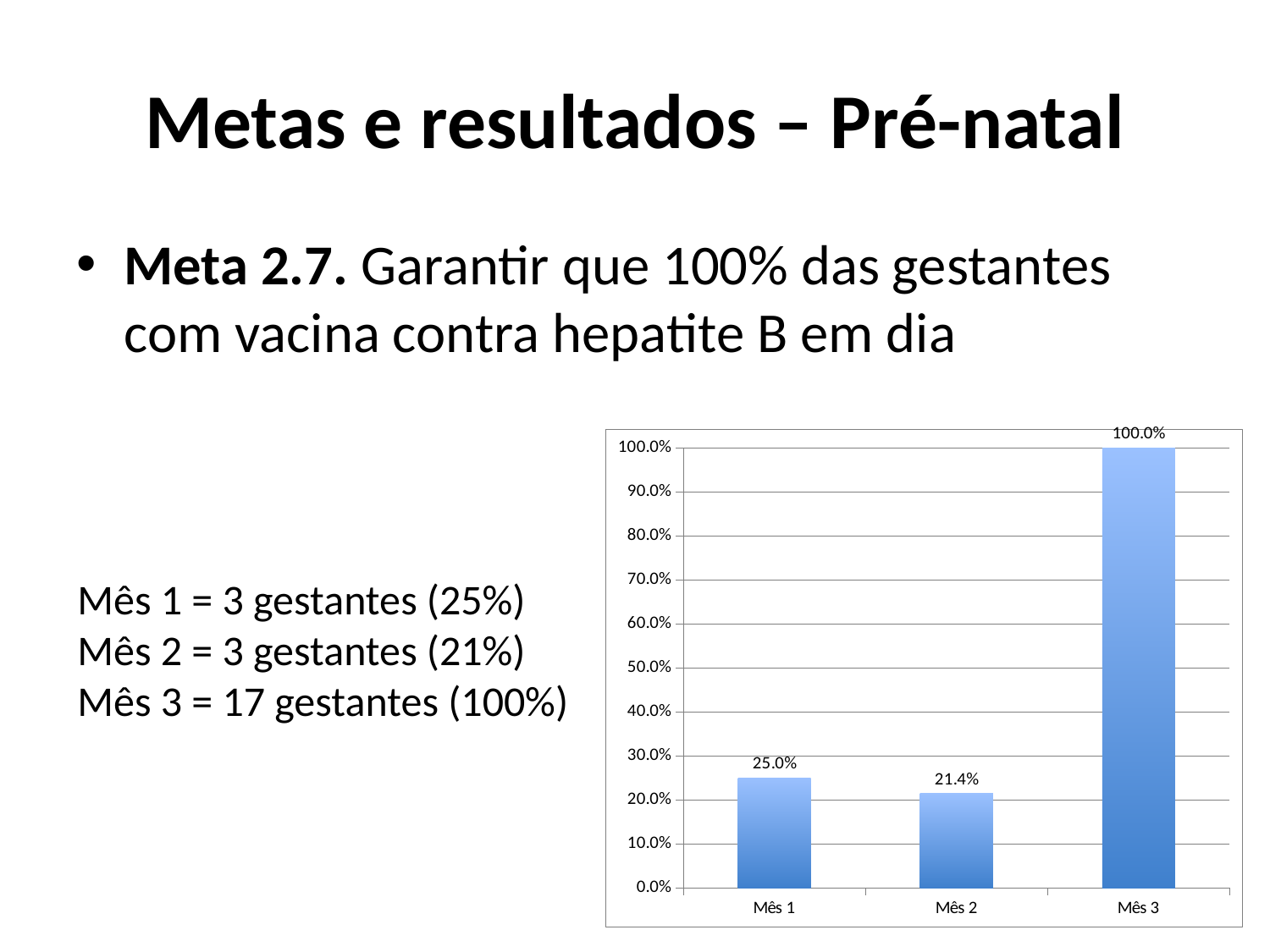
What is the difference between the values for Mês 1 and Mês 2? 3.6% What is the value for Mês 2? 21.4% What kind of chart is shown on the slide? bar chart What is the value for Mês 3? 100.0% Which category has the lowest value? Mês 2 How many categories are shown on the x axis? 3 What is the highest value shown on the y axis? 100.0% Is the value for Mês 2 greater or less than 30.0%? less What is the difference between the values for Mês 3 and Mês 1? 75.0% What is the value for Mês 1? 25.0% Which is larger, the value for Mês 1 or the value for Mês 2? Mês 1 Which category has the highest value? Mês 3